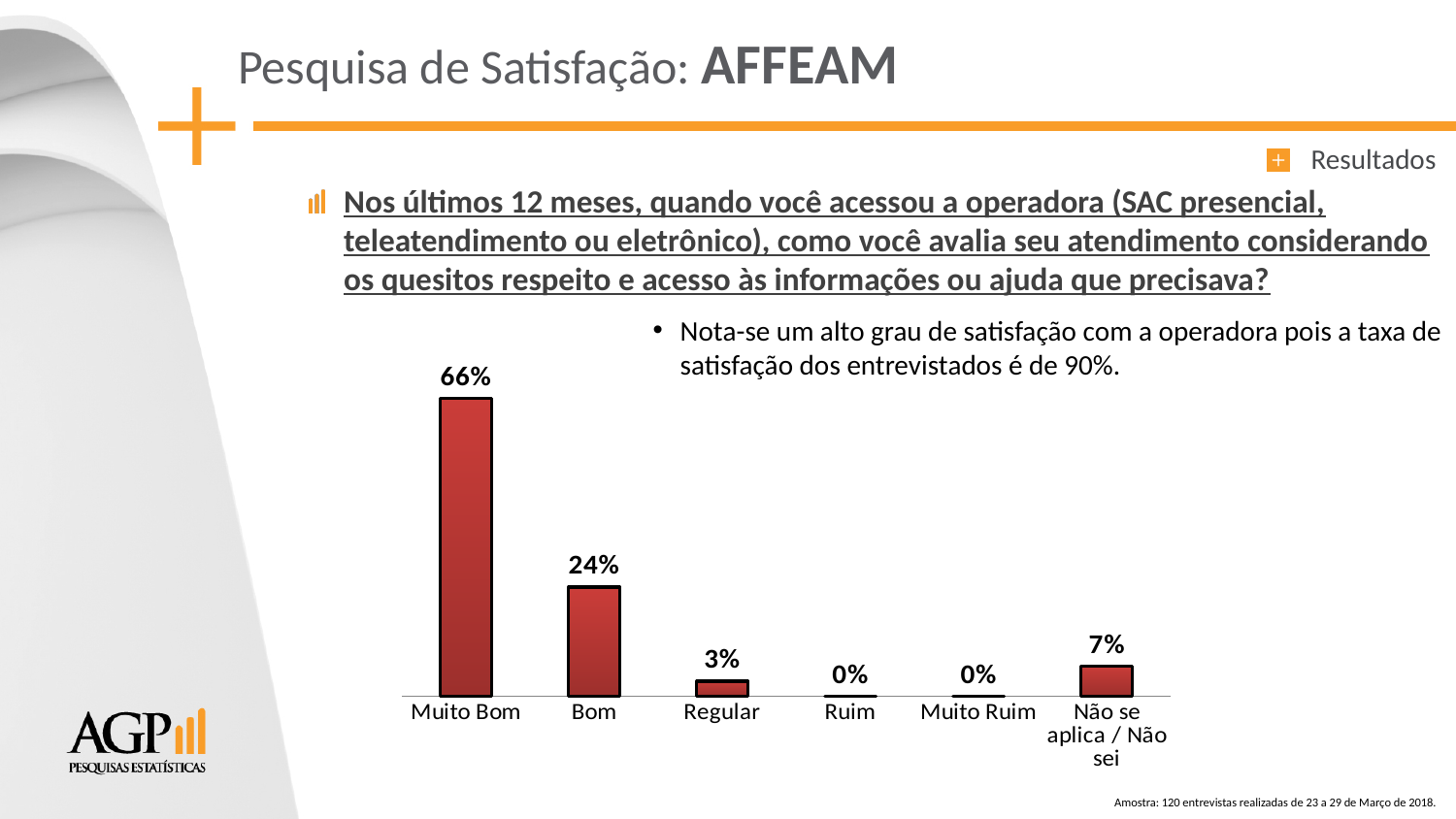
What is the value for Ruim? 0% What kind of chart is shown on the slide? bar chart What is the value for Regular? 3% Which is larger, the value for Regular or the value for Não se aplica / Não sei? Não se aplica / Não sei What is the value for Não se aplica / Não sei? 7% Which category has the highest value? Muito Bom How many categories are shown on the x axis? 6 What is the value for Bom? 24% What is the combined value of Muito Bom and Bom? 90% What is the value for Muito Bom? 66% What colour are the bars in the chart? red What is the difference between the values for Muito Bom and Bom? 42%